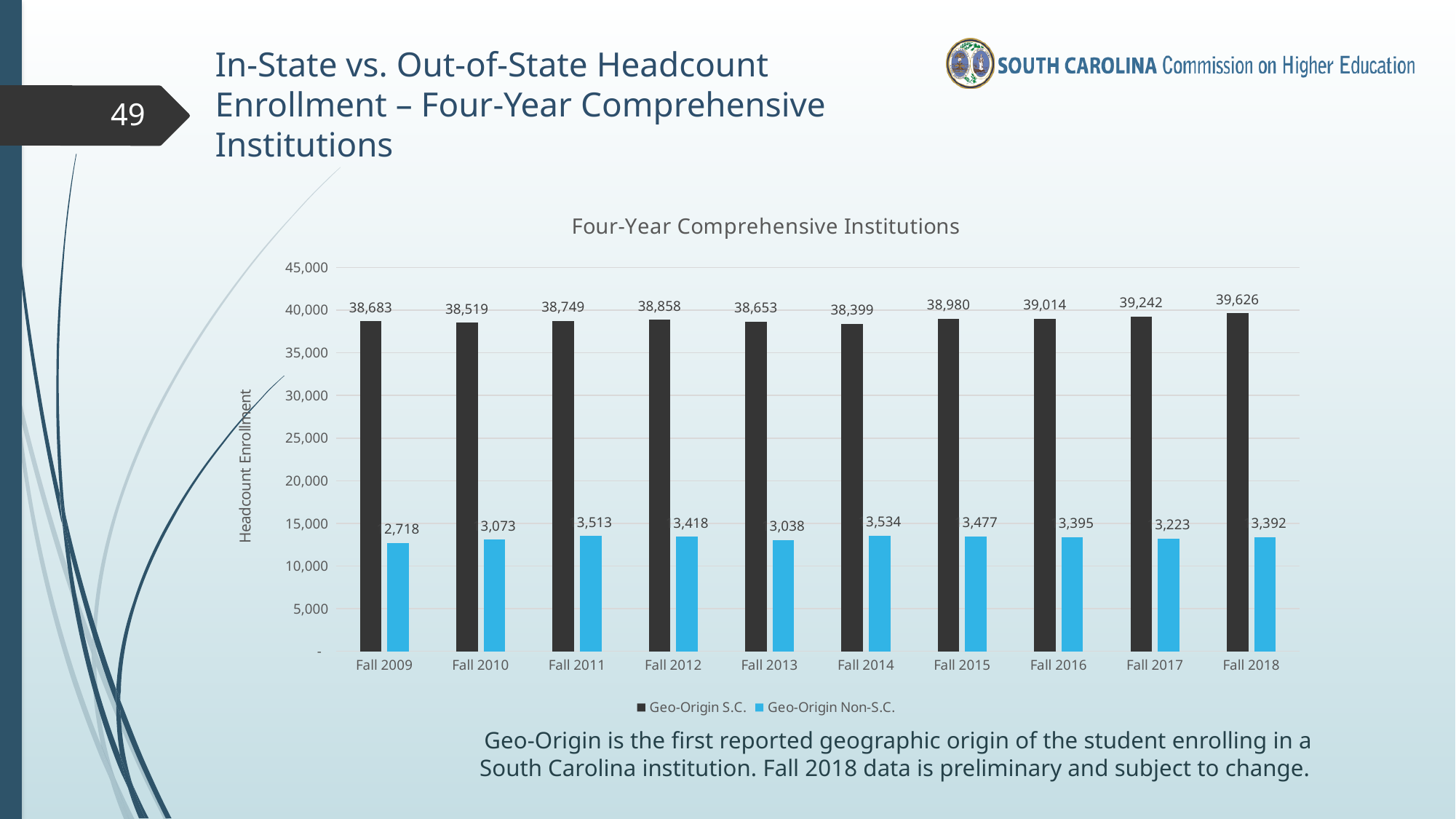
Which fall term has the lowest Geo-Origin Non-S.C. headcount enrollment? Fall 2009 Which is larger, the Geo-Origin Non-S.C. value for Fall 2011 or for Fall 2017? Fall 2011 What is the difference between the Geo-Origin S.C. values for Fall 2018 and Fall 2009? 943 Which fall term has the lowest Geo-Origin S.C. headcount enrollment? Fall 2014 What is the label on the vertical axis of the chart? Headcount Enrollment What kind of chart is shown on the slide? Bar chart What is the Geo-Origin S.C. headcount enrollment for Fall 2018? 39,626 How many series does the legend list? 2 What is the Geo-Origin Non-S.C. value for Fall 2014? 13,534 How many fall terms are shown on the x axis? 10 What is the Geo-Origin Non-S.C. headcount enrollment for Fall 2009? 12,718 Which fall term has the highest Geo-Origin S.C. headcount enrollment? Fall 2018